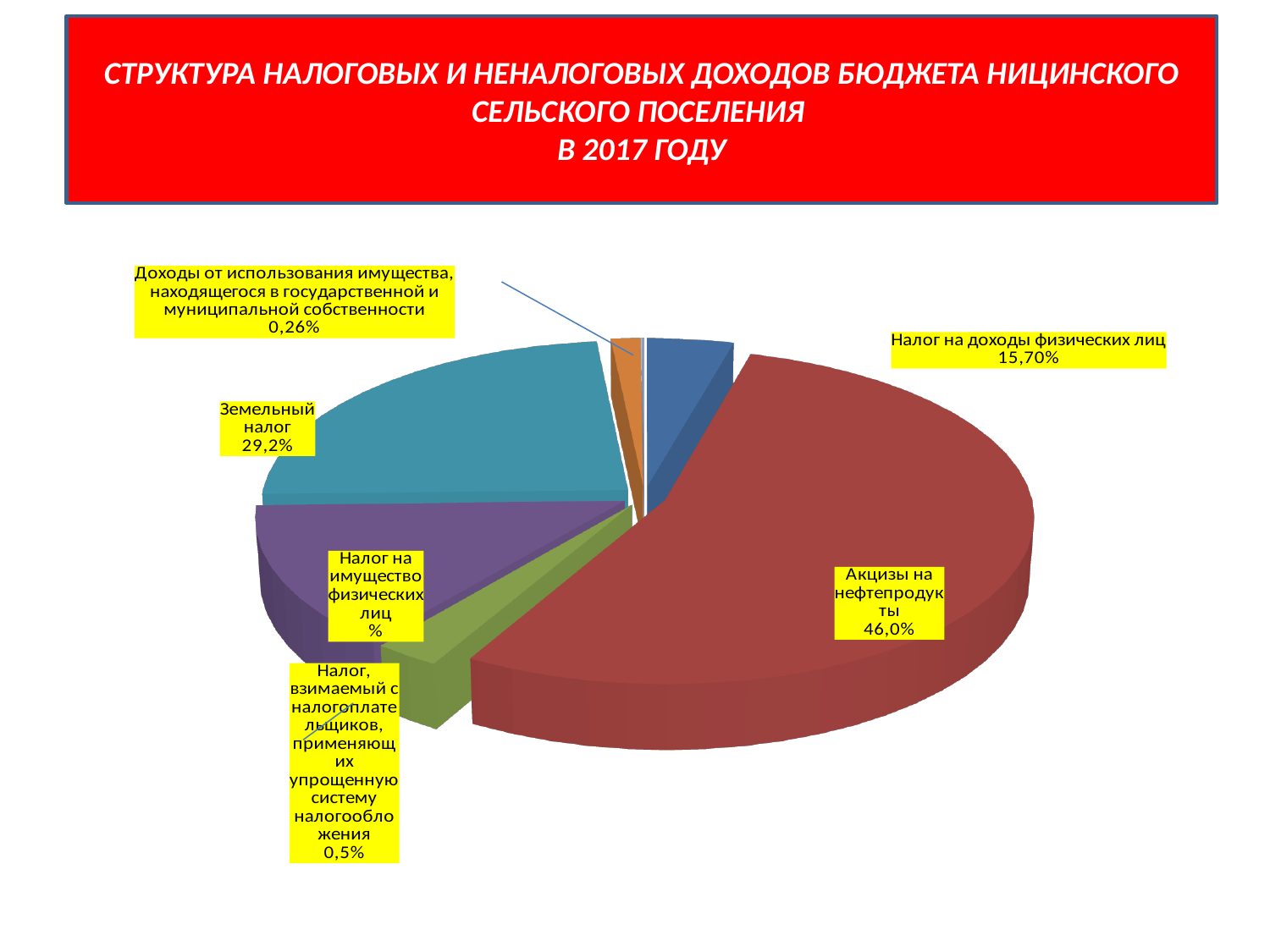
Which revenue source has the largest share of the pie? Акцизы на нефтепродукты What share of the budget revenue comes from Акцизы на нефтепродукты? 46,0% What share is shown for Налог на доходы физических лиц? 15,70% What share is shown for Налог, взимаемый с налогоплательщиков, применяющих упрощенную систему налогообложения? 0,5% What share is shown for Земельный налог? 29,2% By how many percentage points does the share of Акцизы на нефтепродукты exceed the share of Земельный налог? 16,8% What kind of chart is shown on the slide? Pie chart What colour is the slice for Акцизы на нефтепродукты? Red How many slices does the pie chart have? 6 Which revenue source has the smallest share of the pie? Доходы от использования имущества, находящегося в государственной и муниципальной собственности What share is shown for Доходы от использования имущества, находящегося в государственной и муниципальной собственности? 0,26% Which is larger: the share of Земельный налог or the share of Налог на доходы физических лиц? Земельный налог